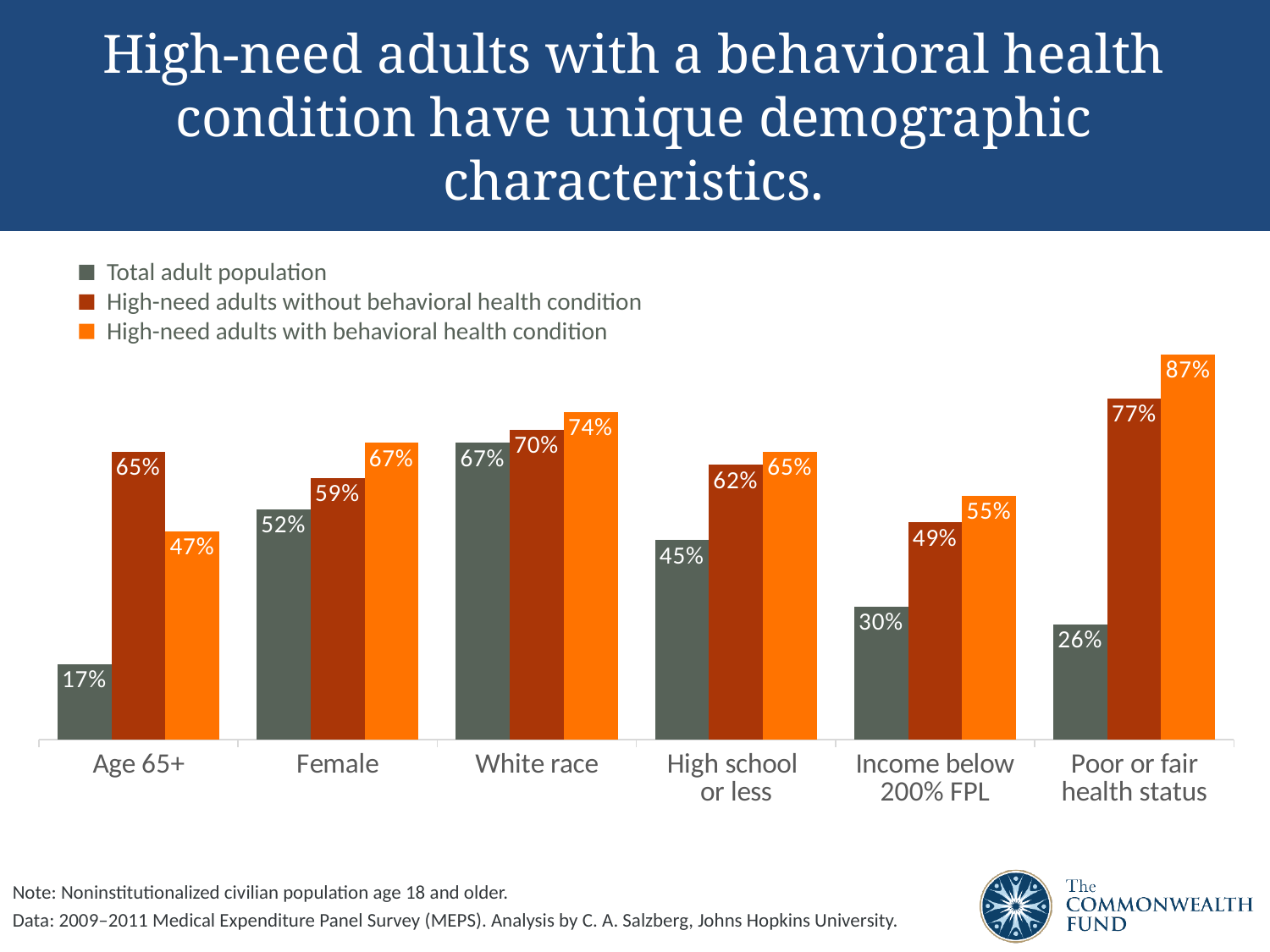
What is the value for High-need adults without behavioral health condition in the Female category? 59% What kind of chart is shown on the slide? Bar chart How many series does the legend list? 3 Which category has the highest value for High-need adults with behavioral health condition? Poor or fair health status Which series is shown in orange in the legend? High-need adults with behavioral health condition In the Income below 200% FPL category, which is larger: Total adult population or High-need adults with behavioral health condition? High-need adults with behavioral health condition What is the value for Total adult population in the Age 65+ category? 17% What is the value for High-need adults with behavioral health condition in the Poor or fair health status category? 87% What is the difference between High-need adults without behavioral health condition and High-need adults with behavioral health condition in the Age 65+ category? 18% How many categories are shown on the x axis? 6 Which category has the lowest value for Total adult population? Age 65+ What is the difference between Total adult population and High-need adults with behavioral health condition in the Poor or fair health status category? 61%